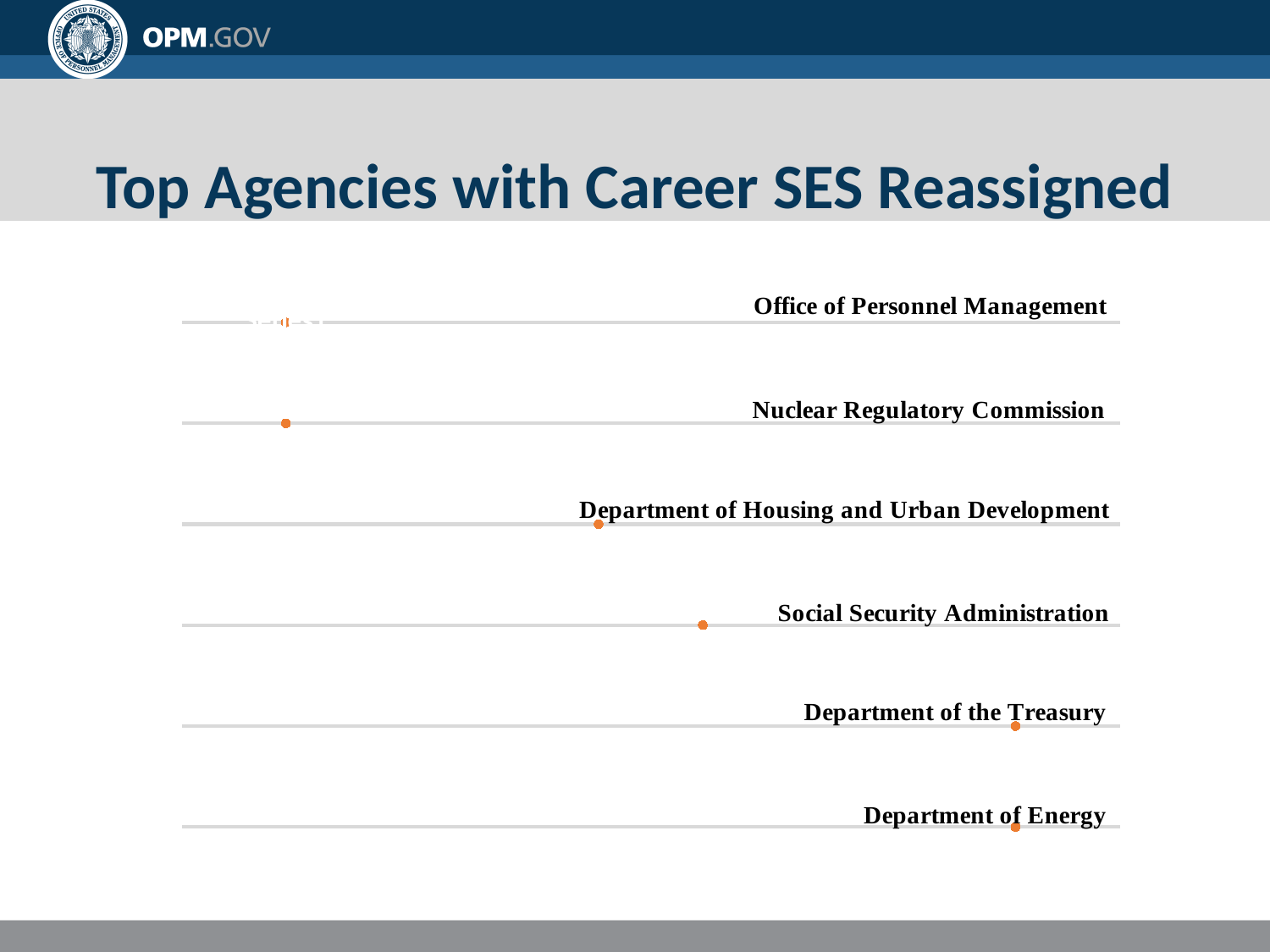
Which agency is listed at the bottom of the chart? Department of Energy How many agencies are plotted on the chart? 6 What is the title of the slide's chart? Top Agencies with Career SES Reassigned What colour are the data markers on the chart? Orange Which agency is listed at the top of the chart? Office of Personnel Management